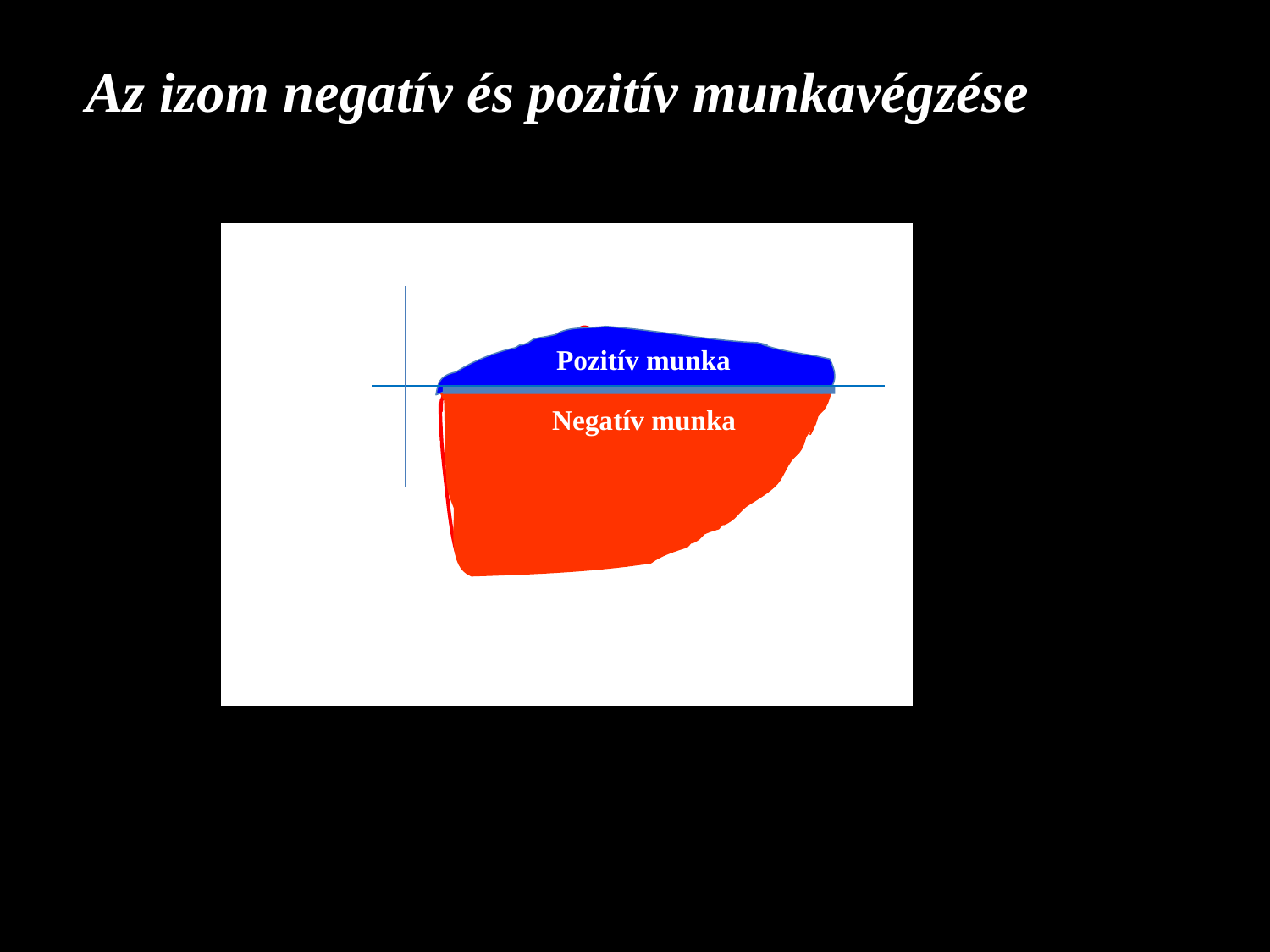
How many labelled regions are shown in the diagram? 2 What colour is the region labelled "Pozitív munka"? Blue Which region covers a larger area, "Pozitív munka" or "Negatív munka"? Negatív munka What is the label on the red region below the horizontal axis? Negatív munka